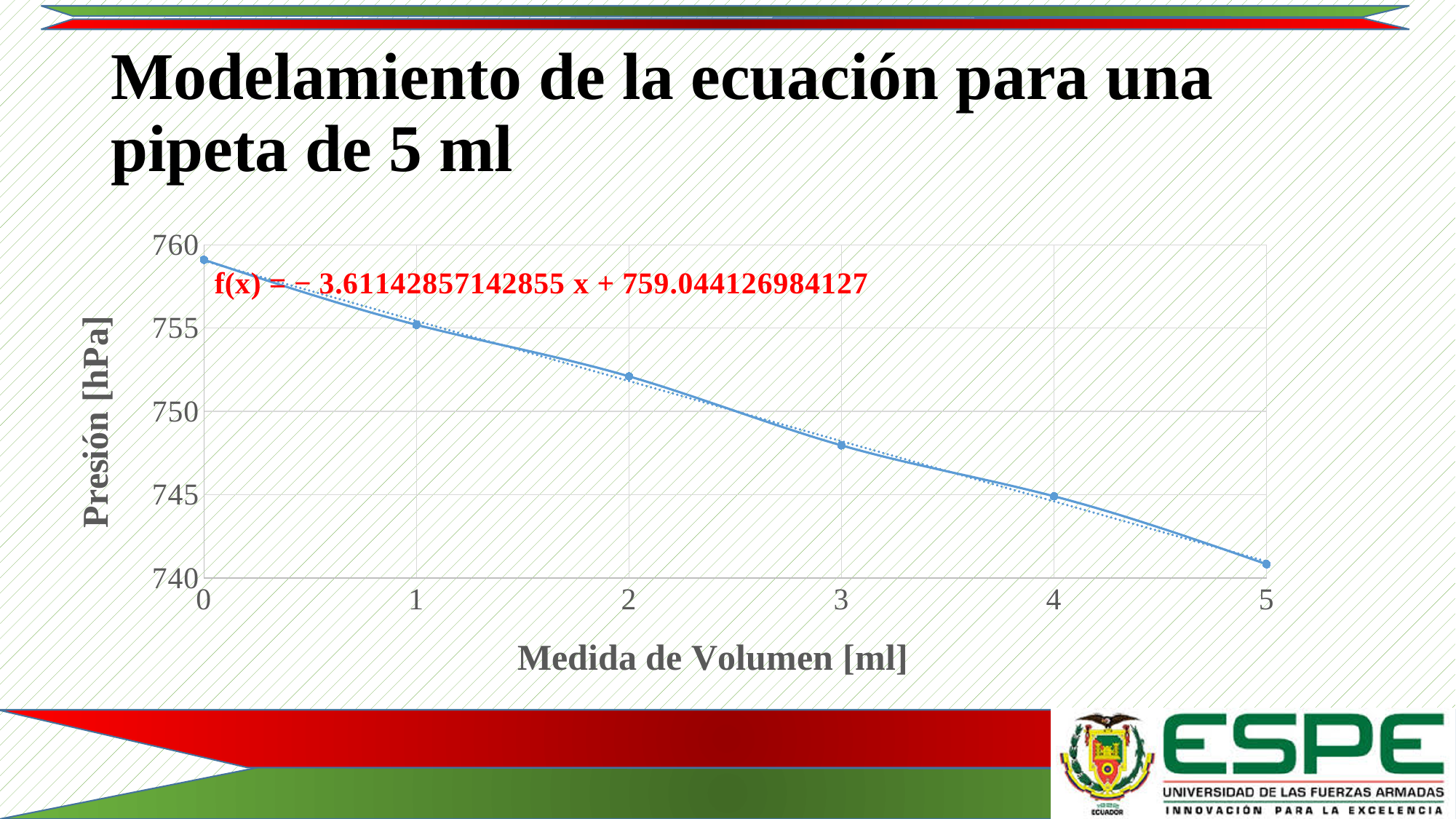
At which volume measurement is the pressure lowest? 5 Is the pressure value at a volume of 4 ml greater or less than 750? less Is the pressure value at a volume of 0 ml greater or less than 755? greater Is the pressure value at a volume of 1 ml greater or less than 750? greater What is the label of the vertical axis? Presión [hPa] What is the label of the horizontal axis? Medida de Volumen [ml] Do the pressure values rise or fall as the volume increases along the x axis? fall At which volume measurement is the pressure highest? 0 How many data points are plotted on the chart? 6 What kind of chart is shown on the slide? line chart Which has the larger pressure value: the point at 2 ml or the point at 3 ml? 2 ml